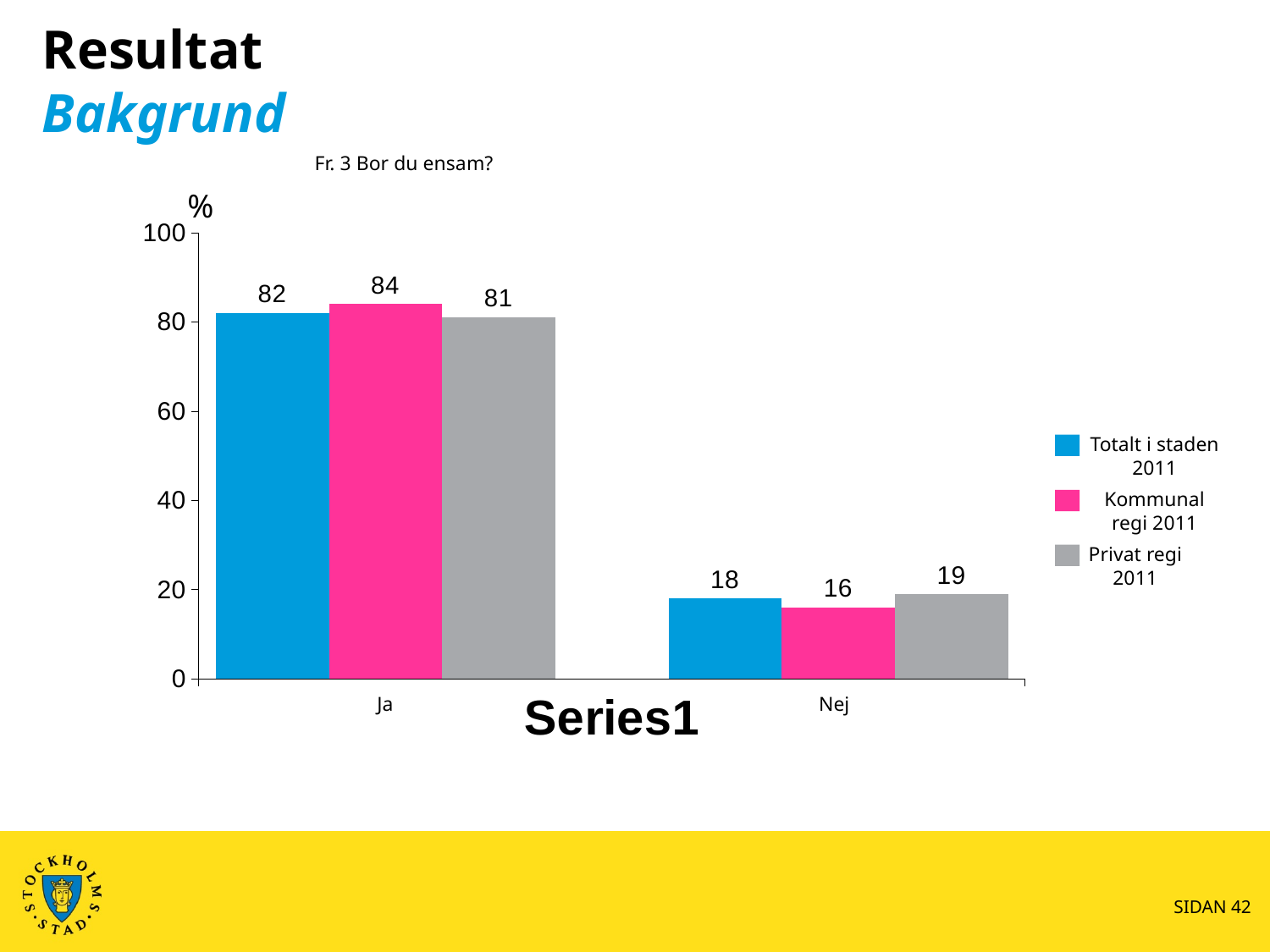
What is the value for Privat regi 2011 in the Ja category? 81 What is the title of the chart? Fr. 3 Bor du ensam? What is the value for Kommunal regi 2011 in the Nej category? 16 How many categories are shown on the x axis? 2 How many series does the legend list? 3 Is the value for Privat regi 2011 in the Nej category greater or less than 20? less Which series has the highest value in the Ja category? Kommunal regi 2011 Which is larger: the Totalt i staden 2011 value for Nej or the Privat regi 2011 value for Nej? Privat regi 2011 What kind of chart is shown on the slide? bar chart Which series has the lowest value in the Nej category? Kommunal regi 2011 What is the value for Totalt i staden 2011 in the Ja category? 82 What is the difference between the Kommunal regi 2011 and Privat regi 2011 values in the Ja category? 3